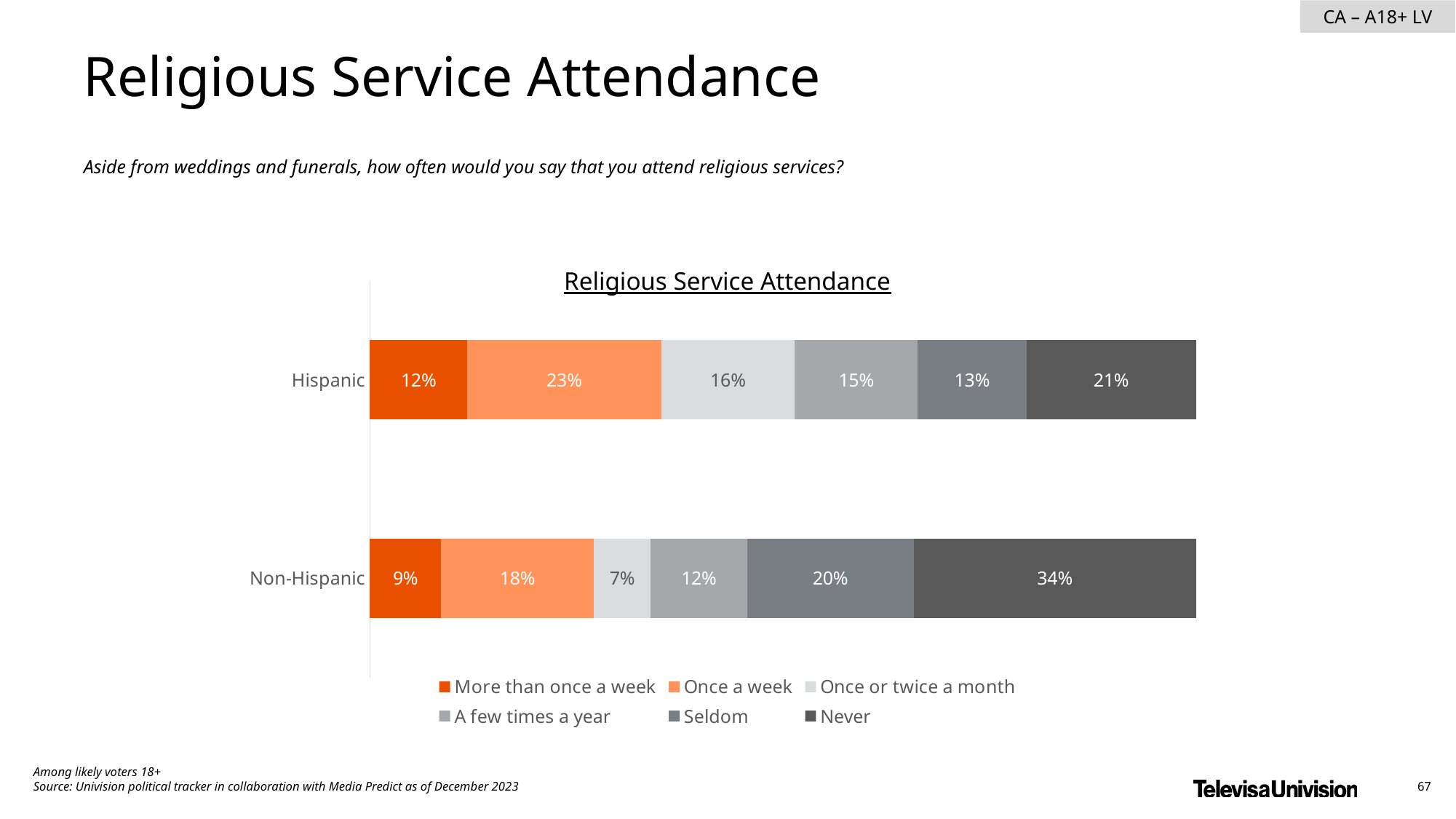
How many percentage points higher is 'Never' for Non-Hispanic than for Hispanic likely voters? 13 What is the value for 'Once or twice a month' in the Non-Hispanic bar? 7% What percentage of Hispanic likely voters say they attend religious services once a week? 23% What is the value for 'Seldom' in the Hispanic bar? 13% How many groups (bars) are shown in the chart? 2 How many series does the legend list? 6 Which response category has the largest share among Non-Hispanic likely voters? Never Which response category has the smallest share among Hispanic likely voters? More than once a week What percentage of Non-Hispanic likely voters say they never attend religious services? 34% Which group has a larger share for 'More than once a week', Hispanic or Non-Hispanic? Hispanic What type of chart is shown on the slide? Stacked bar chart What is the combined share of Hispanic likely voters who attend 'More than once a week' or 'Once a week'? 35%